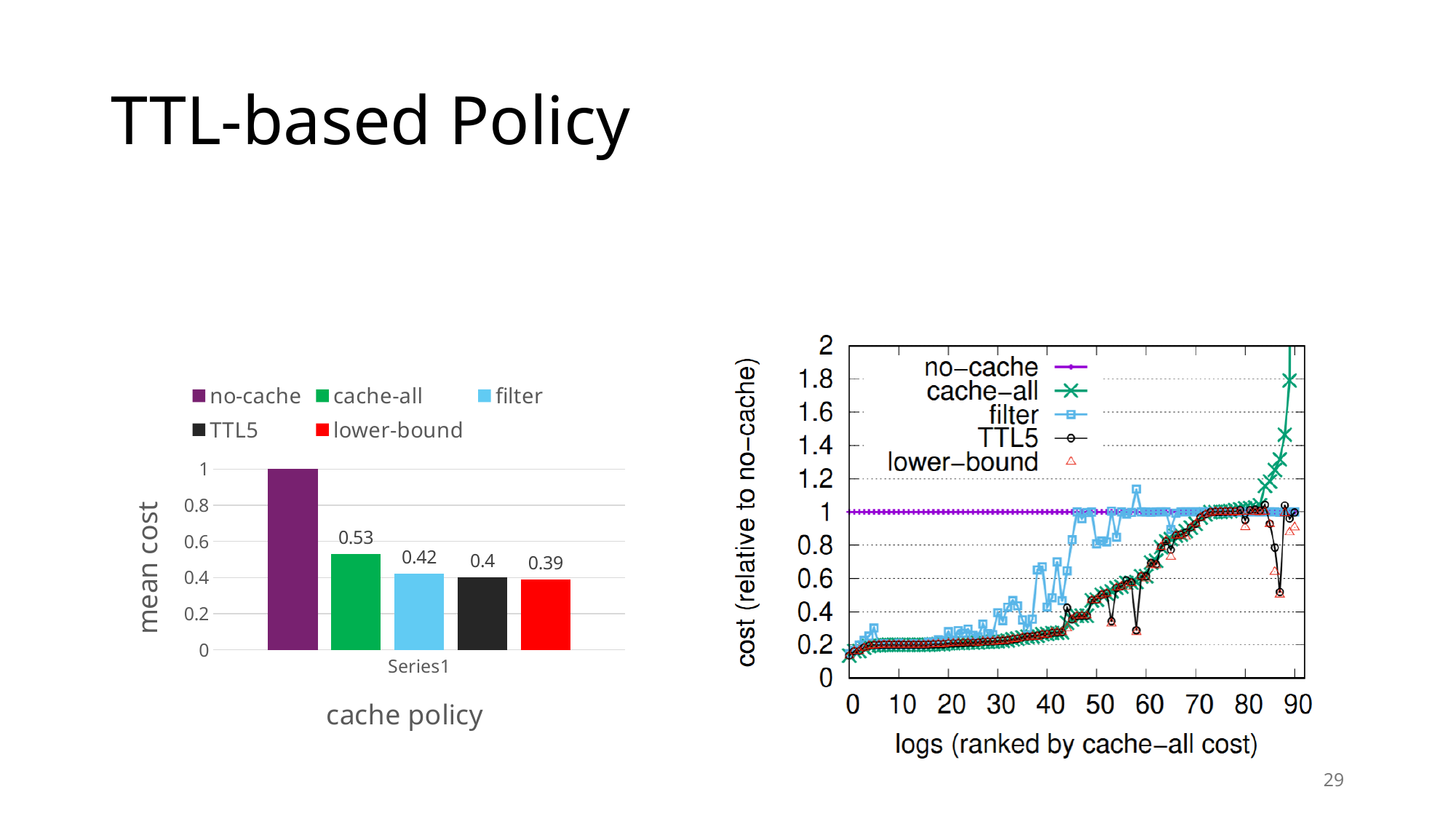
In the right chart, does the cache-all cost rise or fall as the log rank increases along the x axis? rise In the left bar chart, how many series does the legend list? 5 In the left bar chart, which cache policy has the lowest mean cost? lower-bound In the left bar chart, which has a higher mean cost, cache-all or TTL5? cache-all In the left bar chart, what is the mean cost for cache-all? 0.53 In the left bar chart, what is the difference in mean cost between cache-all and filter? 0.11 In the left bar chart, what is the mean cost for TTL5? 0.4 In the left bar chart, which cache policy has the highest mean cost? no-cache In the left bar chart, what is the mean cost for filter? 0.42 What kind of chart is the chart on the left of the slide? bar chart In the left bar chart, what is the mean cost for lower-bound? 0.39 In the right chart, how many series does the legend list? 5